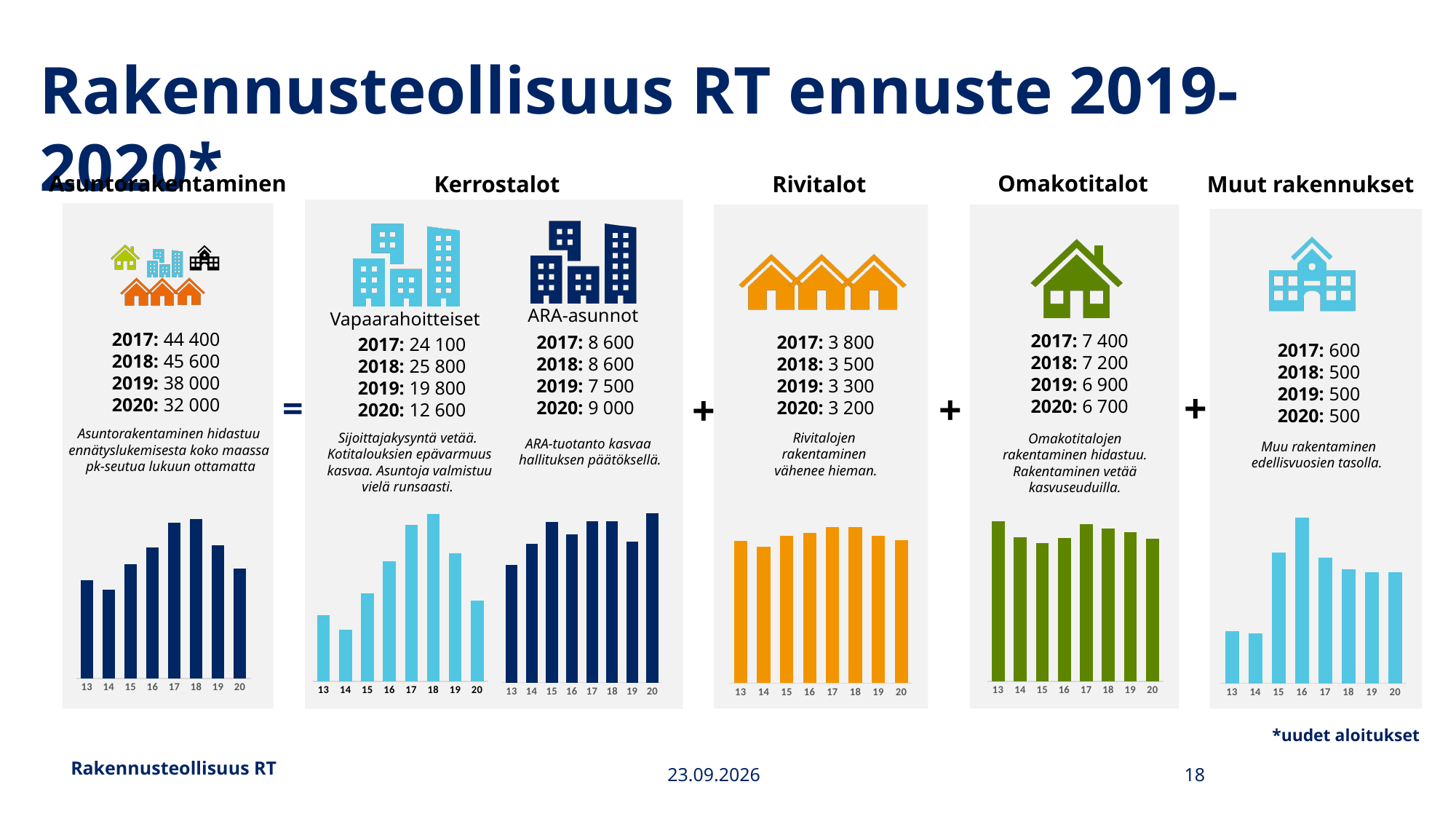
What kind of chart is used in the Rivitalot panel? bar chart In the Kerrostalot ARA-asunnot chart, what is the difference between the 2020 and 2019 values? 1 500 In the Rivitalot chart, which of the years 2017 to 2020 has the highest value? 2017 How many bars are shown in the Muut rakennukset chart? 8 In the Muut rakennukset chart, what is the difference between the 2017 and 2018 values? 100 In the Asuntorakentaminen chart, what is the value for 2018? 45 600 In the Kerrostalot Vapaarahoitteiset chart, what is the value for 2020? 12 600 In the Omakotitalot chart, do the values rise or fall from 2017 to 2020? fall In the Kerrostalot Vapaarahoitteiset chart, do the values rise or fall from 2017 to 2020? fall In the Asuntorakentaminen chart, which is larger, the value for 2017 or for 2020? 2017 What colour are the bars in the Rivitalot chart? orange In the Omakotitalot chart, what is the value for 2019? 6 900